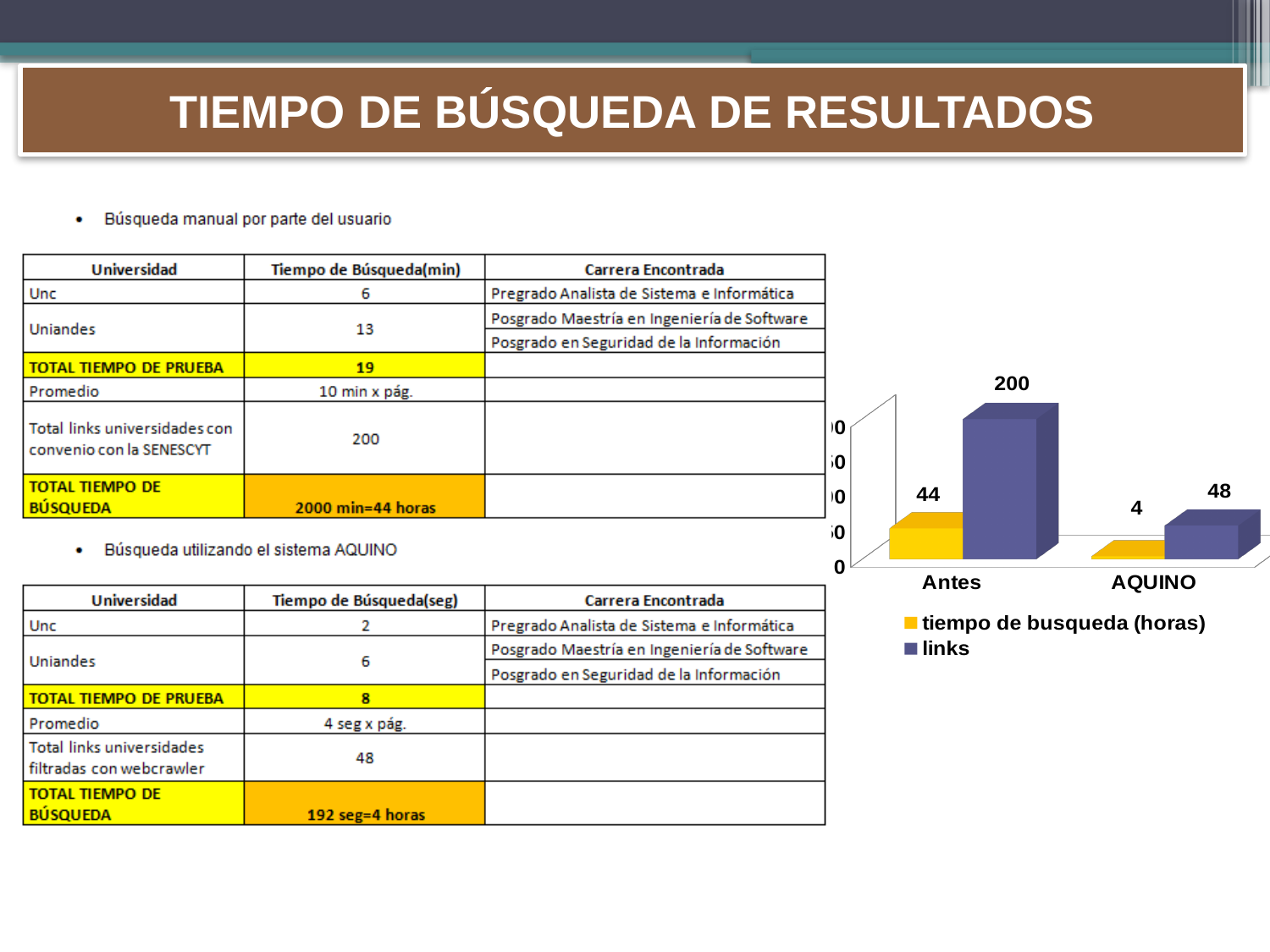
In the bar chart, what is the value of 'links' for Antes? 200 What kind of chart is shown on the right side of the slide? bar chart In the bar chart, is the 'tiempo de busqueda (horas)' value for Antes larger or smaller than the 'links' value for AQUINO? smaller In the bar chart, which category has the lower 'tiempo de busqueda (horas)' value? AQUINO How many categories are shown on the x axis of the bar chart? 2 In the bar chart, what is the value of 'links' for AQUINO? 48 In the bar chart, what is the difference between the 'links' values for Antes and AQUINO? 152 In the bar chart, what is the value of 'tiempo de busqueda (horas)' for AQUINO? 4 In the bar chart, what is the value of 'tiempo de busqueda (horas)' for Antes? 44 In the bar chart, which category has the higher 'links' value? Antes How many series does the legend of the bar chart list? 2 In the bar chart, what is the difference between the 'tiempo de busqueda (horas)' values for Antes and AQUINO? 40